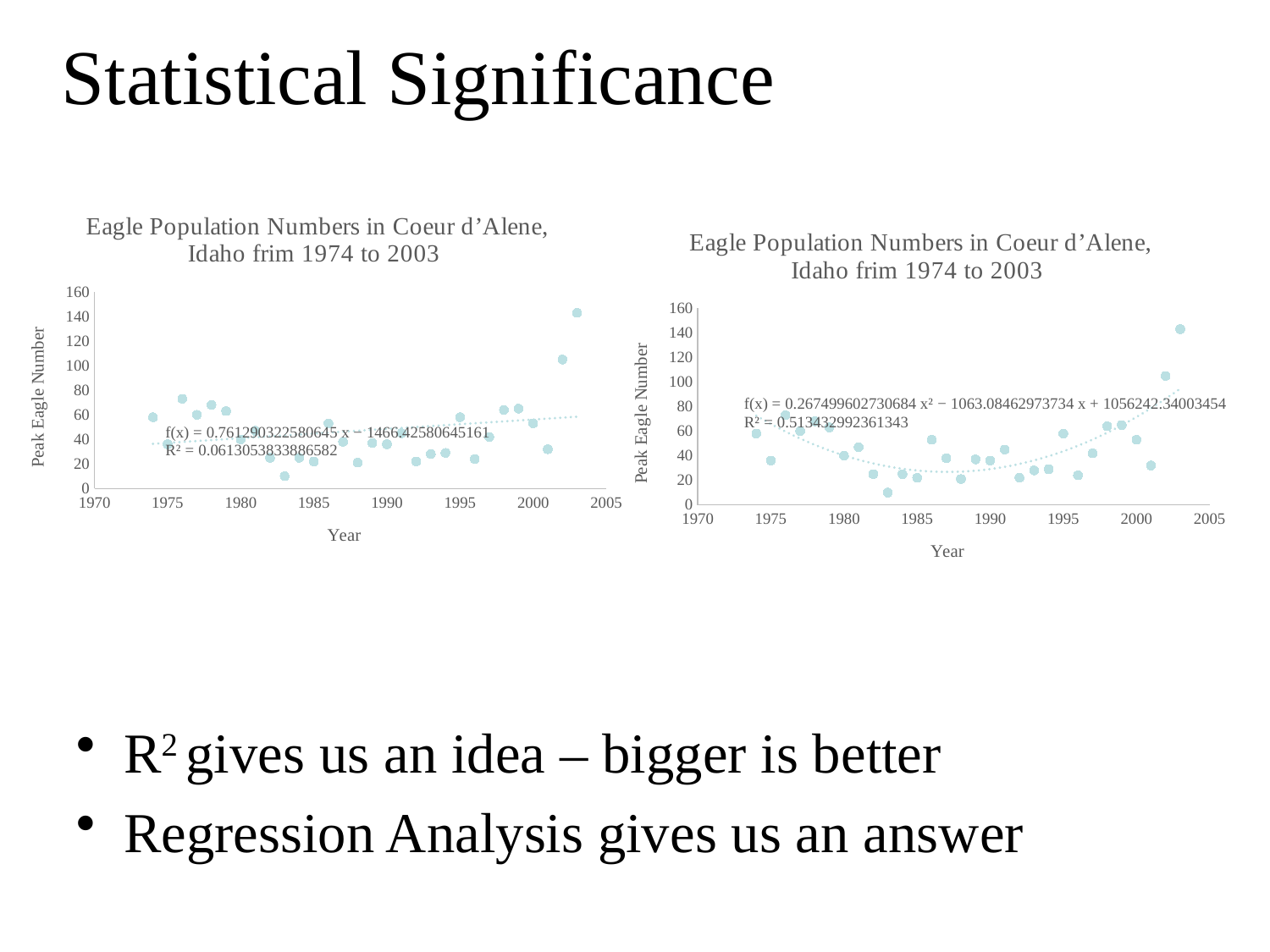
In the left chart, is the value for 2003 greater or less than 120? greater What is the R² value shown on the left chart? 0.0613053833886582 In the right chart, is the value for 1976 greater or less than 60? greater What is the label on the y axis of the right chart? Peak Eagle Number In the left chart, is the value for 2002 greater or less than 80? greater In the left chart, which year has the highest peak eagle number? 2003 What is the title of the left chart? Eagle Population Numbers in Coeur d’Alene, Idaho frim 1974 to 2003 Which chart, left or right, shows the larger R² value? right What is the R² value shown on the right chart? 0.513432992361343 What kind of chart is the left chart on the slide? scatter chart In the right chart, which year has the lowest peak eagle number? 1983